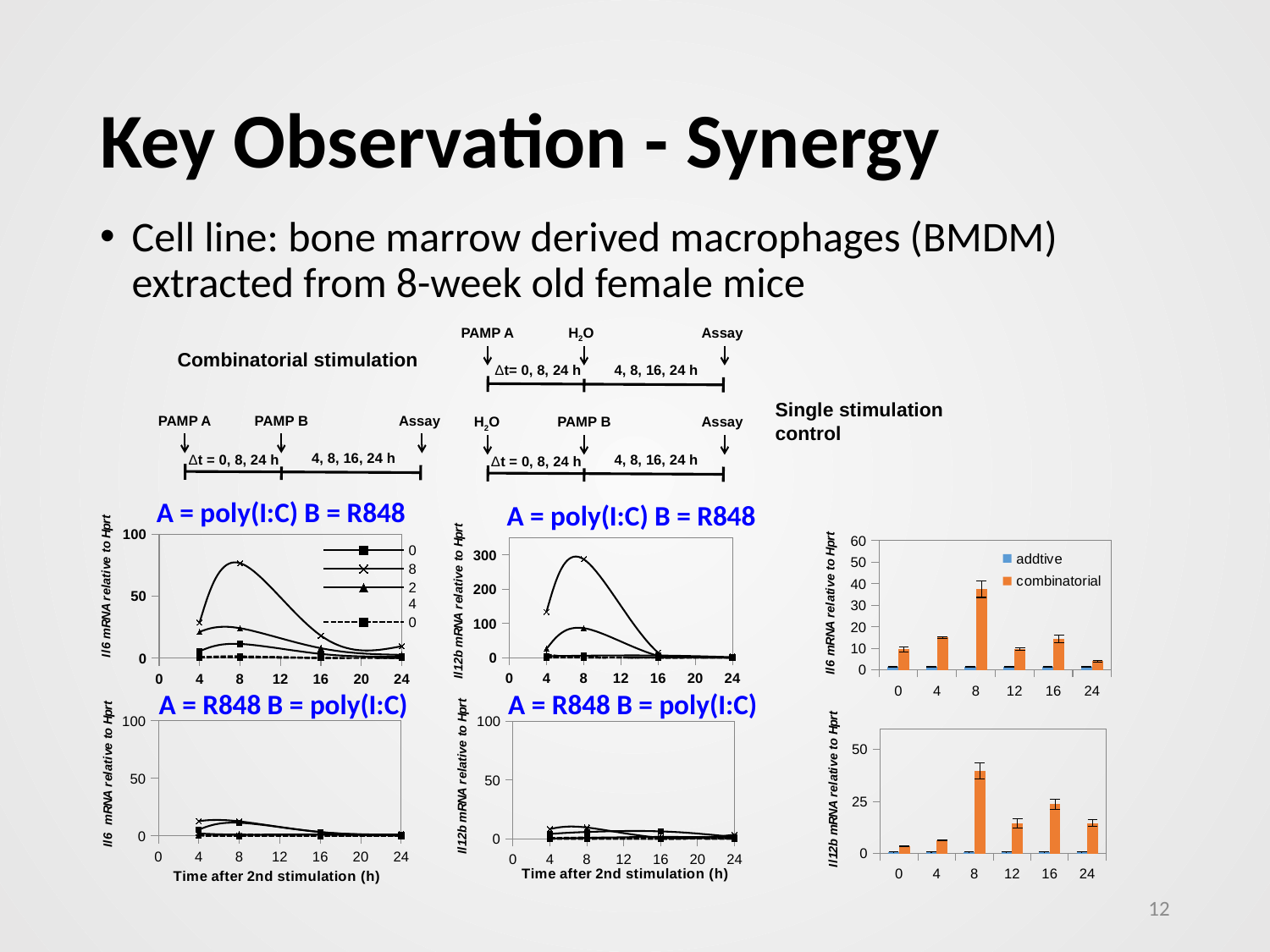
In the top-right bar chart (Il6 mRNA relative to Hprt), is the combinatorial value at 8 greater or less than 30? greater In the top-right bar chart (Il6 mRNA relative to Hprt), at which time point is the combinatorial bar highest? 8 In the top-right bar chart (Il6 mRNA relative to Hprt), is the combinatorial value at 24 greater or less than 10? less In the bottom-right bar chart (Il12b mRNA relative to Hprt), which is larger, the combinatorial value at 8 or at 16? 8 What kind of chart are the two charts on the right side of the slide? bar chart In the top-right bar chart (Il6 mRNA relative to Hprt), how many series does the legend list? 2 In the bottom-right bar chart (Il12b mRNA relative to Hprt), is the combinatorial value at 12 greater or less than 25? less In the bottom-right bar chart (Il12b mRNA relative to Hprt), how many time points are shown on the x axis? 6 What kind of chart is the top-left chart titled 'A = poly(I:C) B = R848' (Il6 mRNA relative to Hprt)? line chart In the top-right bar chart (Il6 mRNA relative to Hprt), what are the two legend entries? addtive and combinatorial In the bottom-right bar chart (Il12b mRNA relative to Hprt), at which time point is the combinatorial bar highest? 8